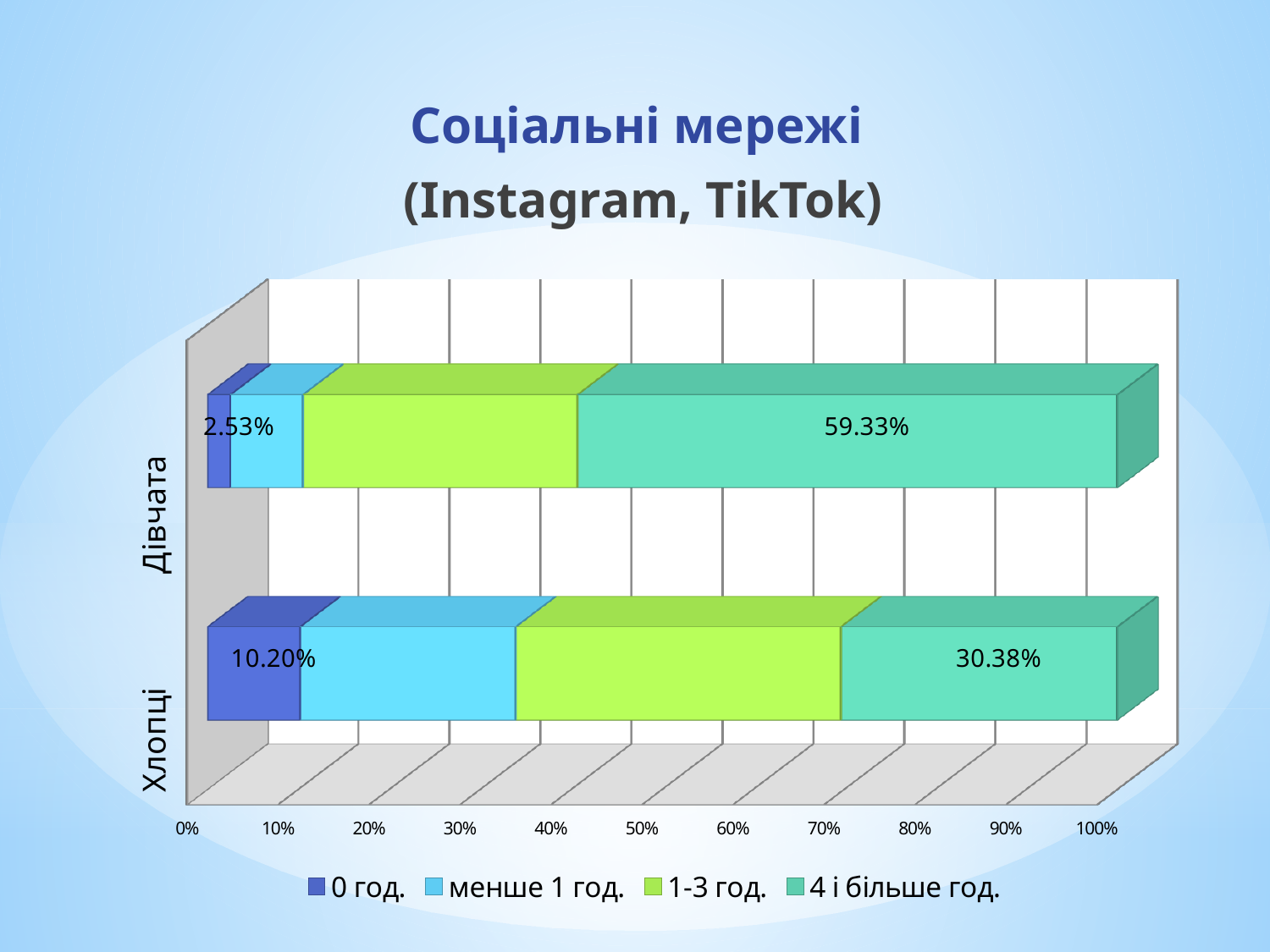
What is the difference between the '4 і більше год.' values for Дівчата and Хлопці? 28.95% What is the value of the '4 і більше год.' segment for Хлопці? 30.38% What is the value of the '0 год.' segment for Дівчата? 2.53% What is the value of the '0 год.' segment for Хлопці? 10.20% Which category has the higher '0 год.' value? Хлопці Is the 'менше 1 год.' segment for Хлопці greater or less than 20%? greater What kind of chart is shown on the slide? Stacked bar chart How many series does the legend list? 4 What is the difference between the '0 год.' values for Хлопці and Дівчата? 7.67% How many categories are shown on the chart? 2 What is the value of the '4 і більше год.' segment for Дівчата? 59.33% Which category has the larger '4 і більше год.' value, Дівчата or Хлопці? Дівчата